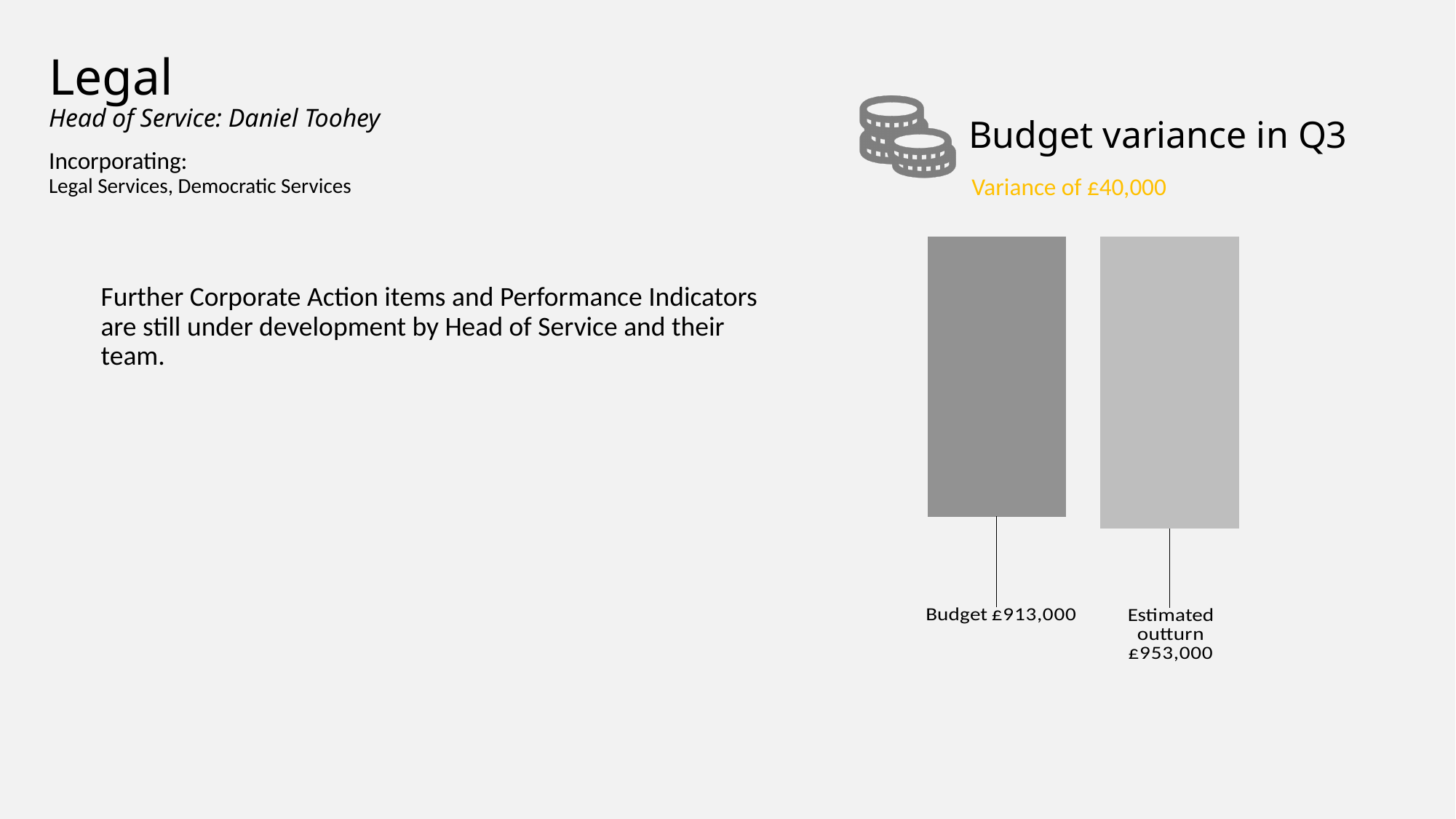
What is the value of the Estimated outturn bar? £953,000 What is the difference between the Estimated outturn and the Budget? £40,000 Is the Estimated outturn larger or smaller than the Budget? larger Which bar has the lower value, Budget or Estimated outturn? Budget What is the title of the chart? Budget variance in Q3 What kind of chart is shown on the slide? bar chart What variance amount is stated above the chart? Variance of £40,000 Which bar has the higher value, Budget or Estimated outturn? Estimated outturn How many bars are shown in the chart? 2 What is the value of the Budget bar? £913,000